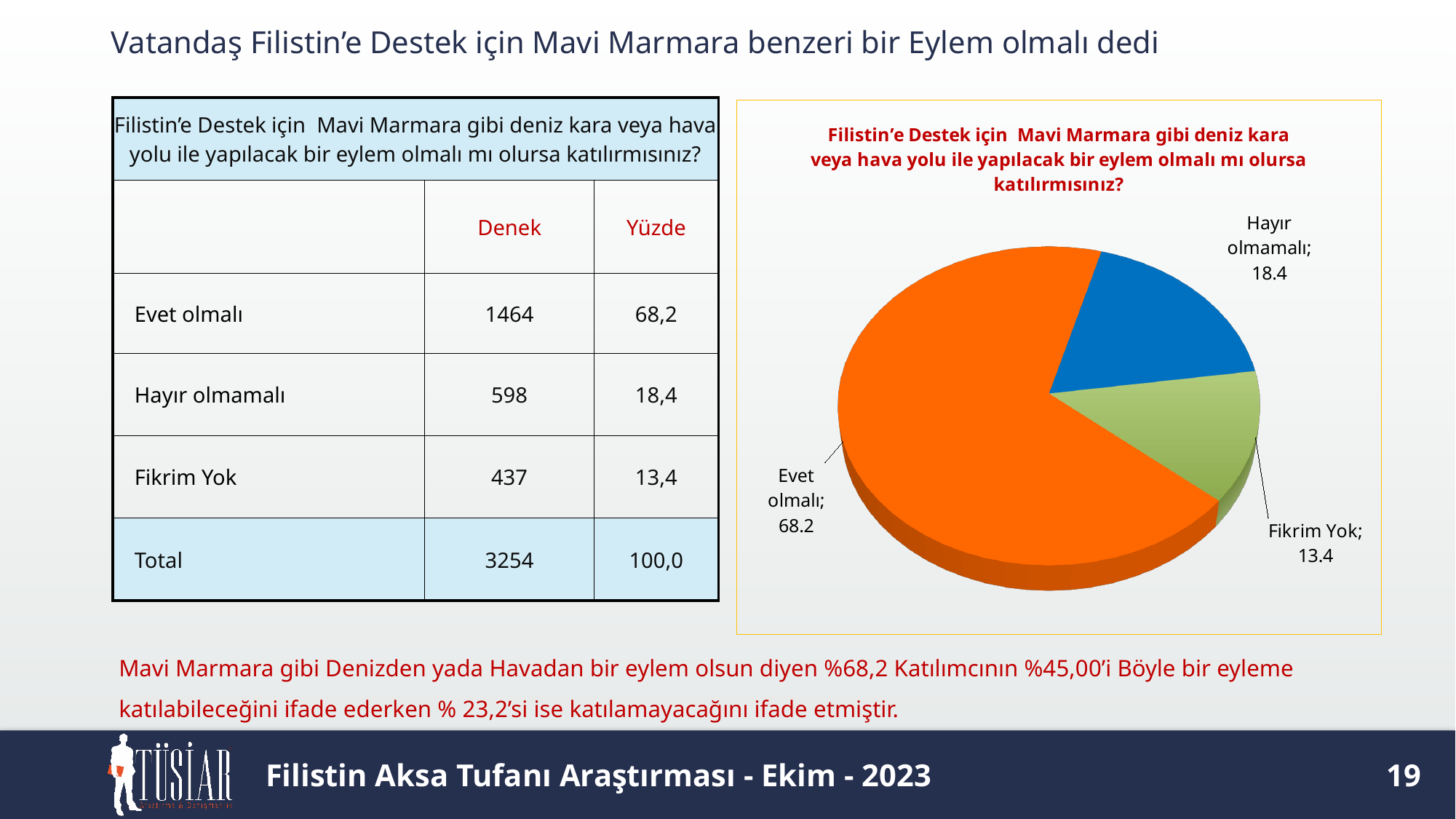
What colour is the "Evet olmalı" slice in the pie chart? orange What colour is the "Hayır olmamalı" slice in the pie chart? blue Which is larger in the pie chart, "Hayır olmamalı" or "Fikrim Yok"? Hayır olmamalı What is the value shown for the "Evet olmalı" slice in the pie chart? 68.2 Which category has the largest slice in the pie chart? Evet olmalı What is the value shown for the "Fikrim Yok" slice in the pie chart? 13.4 Which category has the smallest slice in the pie chart? Fikrim Yok What type of chart is shown on the slide? pie chart How many slices does the pie chart have? 3 What is the difference between the values for "Hayır olmamalı" and "Fikrim Yok" in the pie chart? 5.0 What is the difference between the values for "Evet olmalı" and "Hayır olmamalı" in the pie chart? 49.8 What is the value shown for the "Hayır olmamalı" slice in the pie chart? 18.4